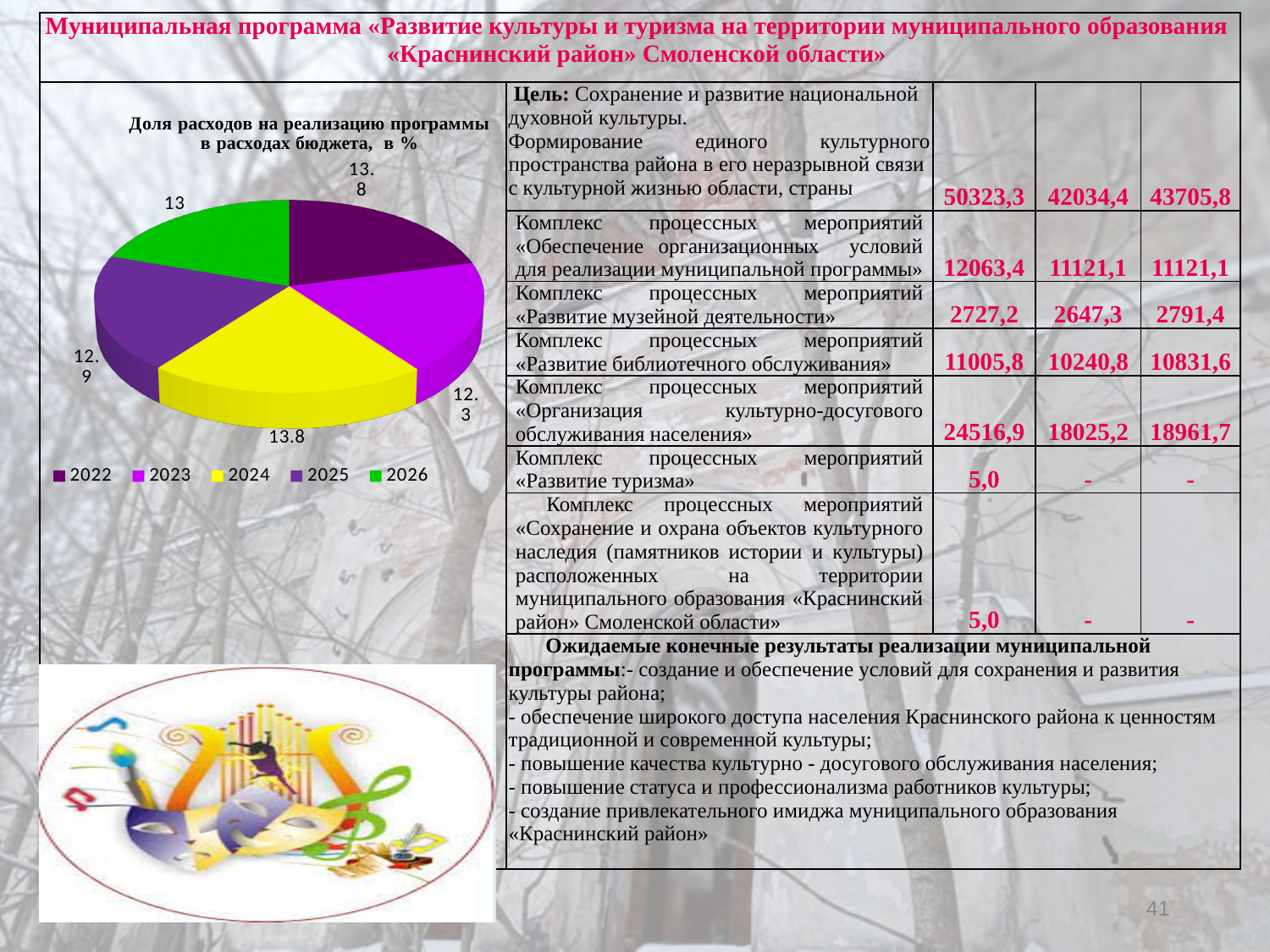
Which colour represents 2024 in the pie chart? yellow Which is larger in the pie chart, the value for 2023 or the value for 2026? 2026 What type of chart is shown on the slide? pie chart What is the value shown for 2026 in the pie chart? 13 What is the value shown for 2024 in the pie chart? 13.8 What is the title of the pie chart? Доля расходов на реализацию программы в расходах бюджета, в % What is the value shown for 2025 in the pie chart? 12.9 What is the difference between the values for 2024 and 2023 in the pie chart? 1.5 How many slices does the pie chart have? 5 What is the value shown for 2023 in the pie chart? 12.3 How many entries does the legend of the pie chart list? 5 Which year has the smallest slice in the pie chart? 2023